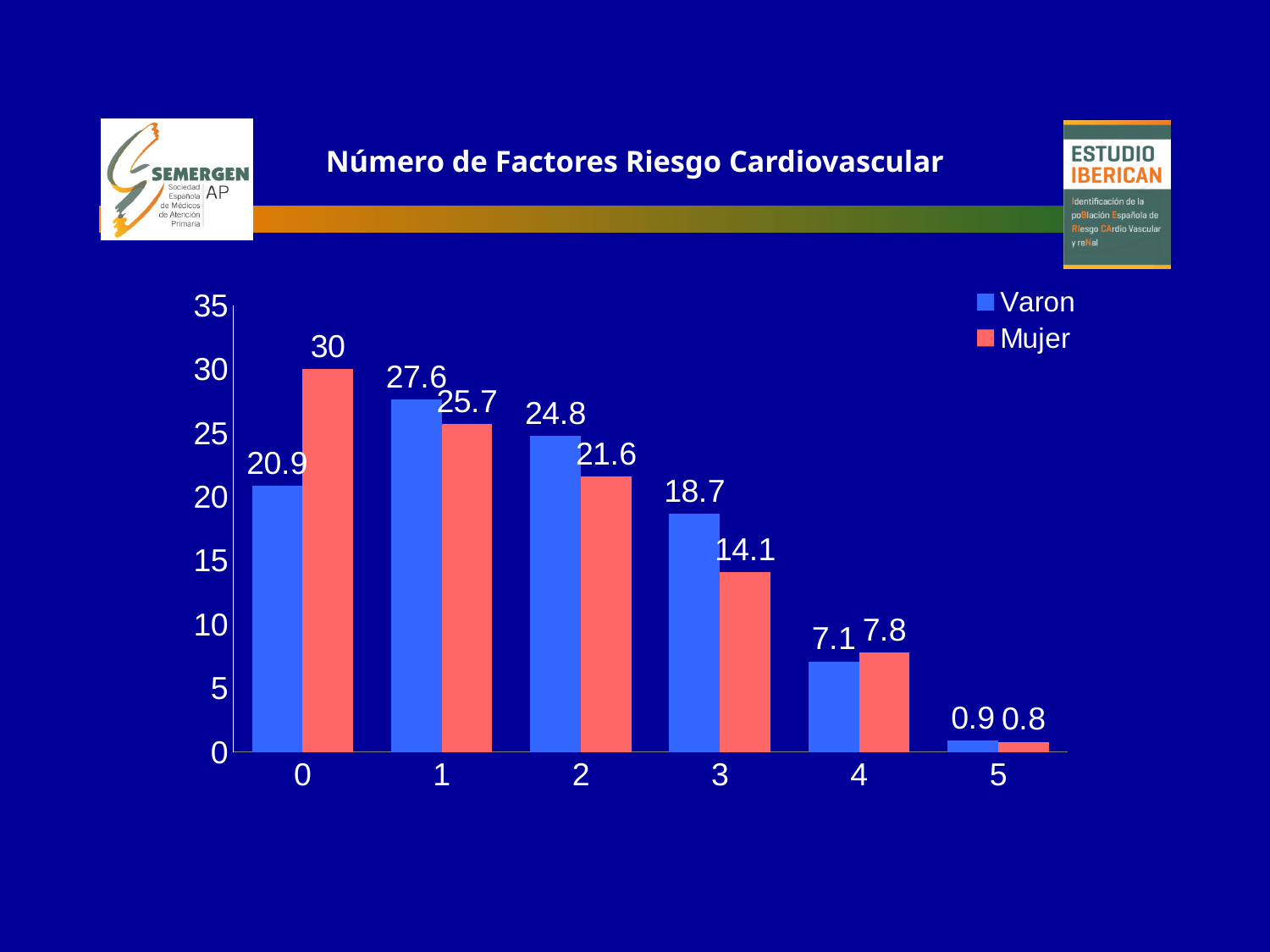
What is the value for Mujer at category 3? 14.1 What is the difference between the Mujer and Varon values at category 0? 9.1 What is the value for Mujer at category 5? 0.8 What kind of chart is shown on the slide? bar chart How many series does the legend list? 2 Is the value for Mujer at category 1 greater or less than 25? greater How many categories are shown on the x axis? 6 What is the value for Varon at category 0? 20.9 What is the title of the chart? Número de Factores Riesgo Cardiovascular Which category has the lowest value for Mujer? 5 Which category has the highest value for Varon? 1 At category 2, which series has the larger value, Varon or Mujer? Varon